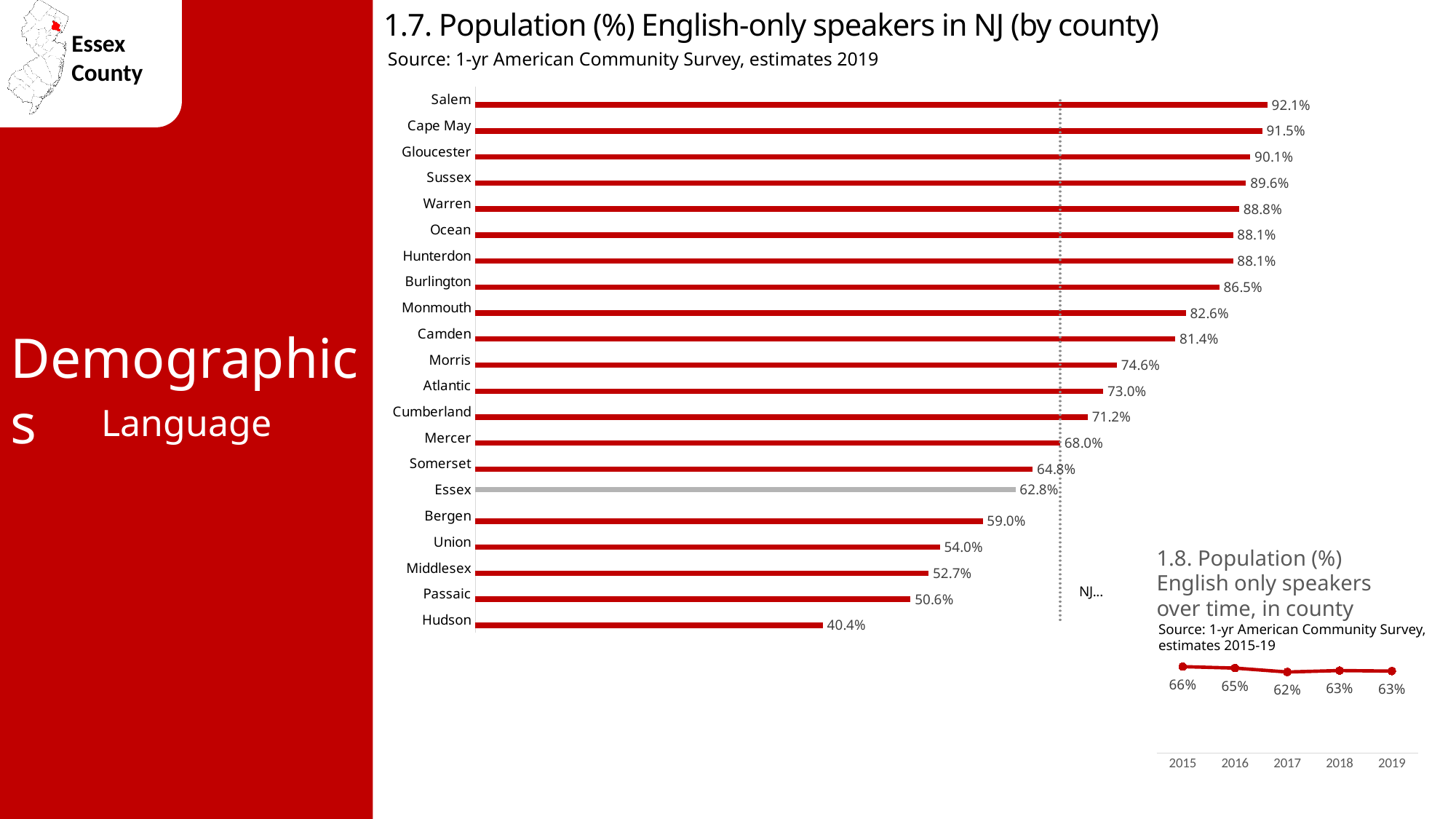
In the chart '1.7. Population (%) English-only speakers in NJ (by county)', what is the value for Hudson? 40.4% In the chart '1.8. Population (%) English only speakers over time, in county', do the values rise or fall from 2015 to 2019? Fall In the chart '1.8. Population (%) English only speakers over time, in county', what is the value for 2015? 66% In the chart '1.7. Population (%) English-only speakers in NJ (by county)', which county has the lowest value? Hudson In the chart '1.7. Population (%) English-only speakers in NJ (by county)', what is the difference between Salem and Hudson? 51.7% In the chart '1.7. Population (%) English-only speakers in NJ (by county)', which county's bar is coloured grey instead of red? Essex In the chart '1.7. Population (%) English-only speakers in NJ (by county)', which county has the highest value? Salem In the chart '1.7. Population (%) English-only speakers in NJ (by county)', how many counties are shown? 21 In the chart '1.7. Population (%) English-only speakers in NJ (by county)', what is the value for Essex? 62.8% In the chart '1.7. Population (%) English-only speakers in NJ (by county)', which is larger, Bergen or Union? Bergen What kind of chart is '1.7. Population (%) English-only speakers in NJ (by county)'? Bar chart In the chart '1.8. Population (%) English only speakers over time, in county', what is the value for 2017? 62%